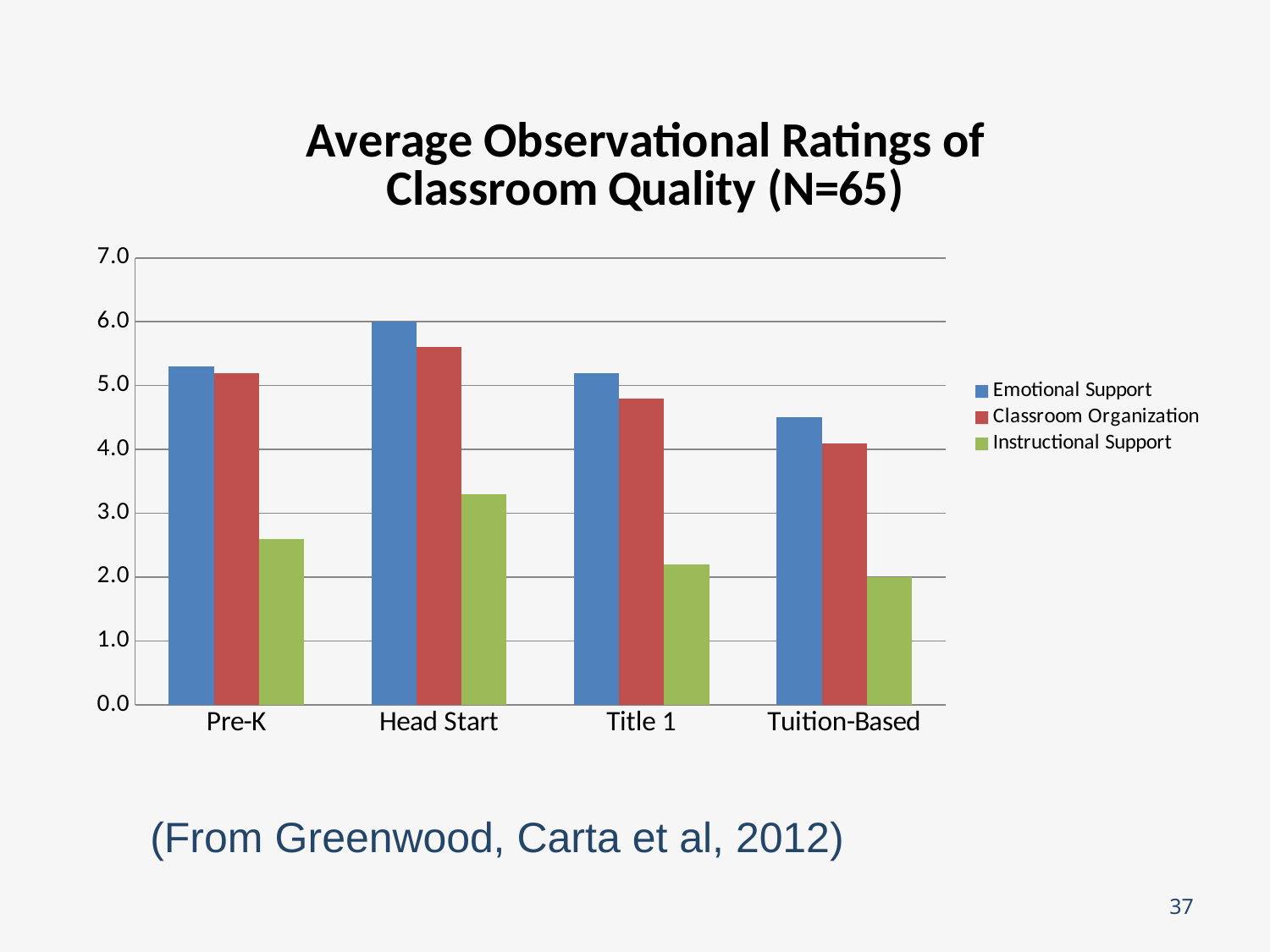
What type of chart is shown on the slide? bar chart What is the Emotional Support value for Head Start? 6.0 What is the title of the chart? Average Observational Ratings of Classroom Quality (N=65) What is the Instructional Support value for Tuition-Based? 2.0 How many program categories are shown on the x axis? 4 Which category has the lowest Classroom Organization rating? Tuition-Based Which category has the highest Emotional Support rating? Head Start Which category has the highest Instructional Support rating? Head Start Is the Instructional Support value for Pre-K greater or less than 3.0? less Which is larger, the Emotional Support value for Head Start or for Title 1? Head Start Is the Classroom Organization value for Head Start greater or less than 5.0? greater How many series does the legend list? 3